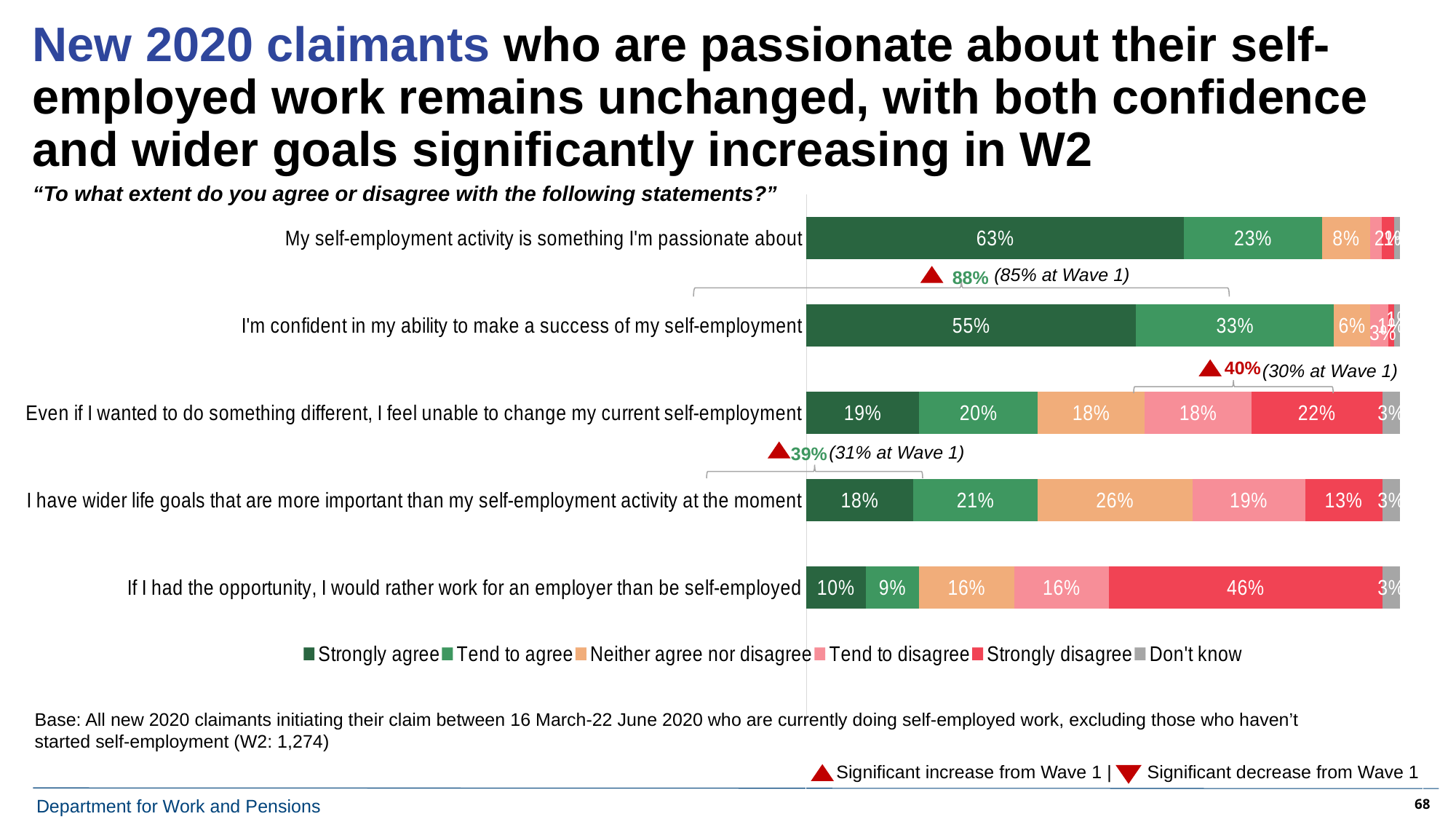
What percentage strongly agree that their self-employment activity is something they are passionate about? 63% Which statement has a larger 'Strongly disagree' share: 'Even if I wanted to do something different, I feel unable to change my current self-employment' or 'I have wider life goals that are more important than my self-employment activity at the moment'? Even if I wanted to do something different, I feel unable to change my current self-employment What is the 'Tend to agree' value for 'I'm confident in my ability to make a success of my self-employment'? 33% How many statements are shown in the chart? 5 Which statement has the highest 'Strongly agree' percentage? My self-employment activity is something I'm passionate about What percentage strongly disagree with the statement 'If I had the opportunity, I would rather work for an employer than be self-employed'? 46% What is the 'Neither agree nor disagree' value for the statement about having wider life goals that are more important than self-employment? 26% For the statement about being confident in making a success of self-employment, how many percentage points higher is 'Strongly agree' than 'Tend to agree'? 22 percentage points What is the combined 'Strongly agree' and 'Tend to agree' percentage for 'If I had the opportunity, I would rather work for an employer than be self-employed'? 19% Which statement has the lowest 'Strongly agree' percentage? If I had the opportunity, I would rather work for an employer than be self-employed What kind of chart is shown on the slide? Stacked bar chart How many response categories does the legend list? 6